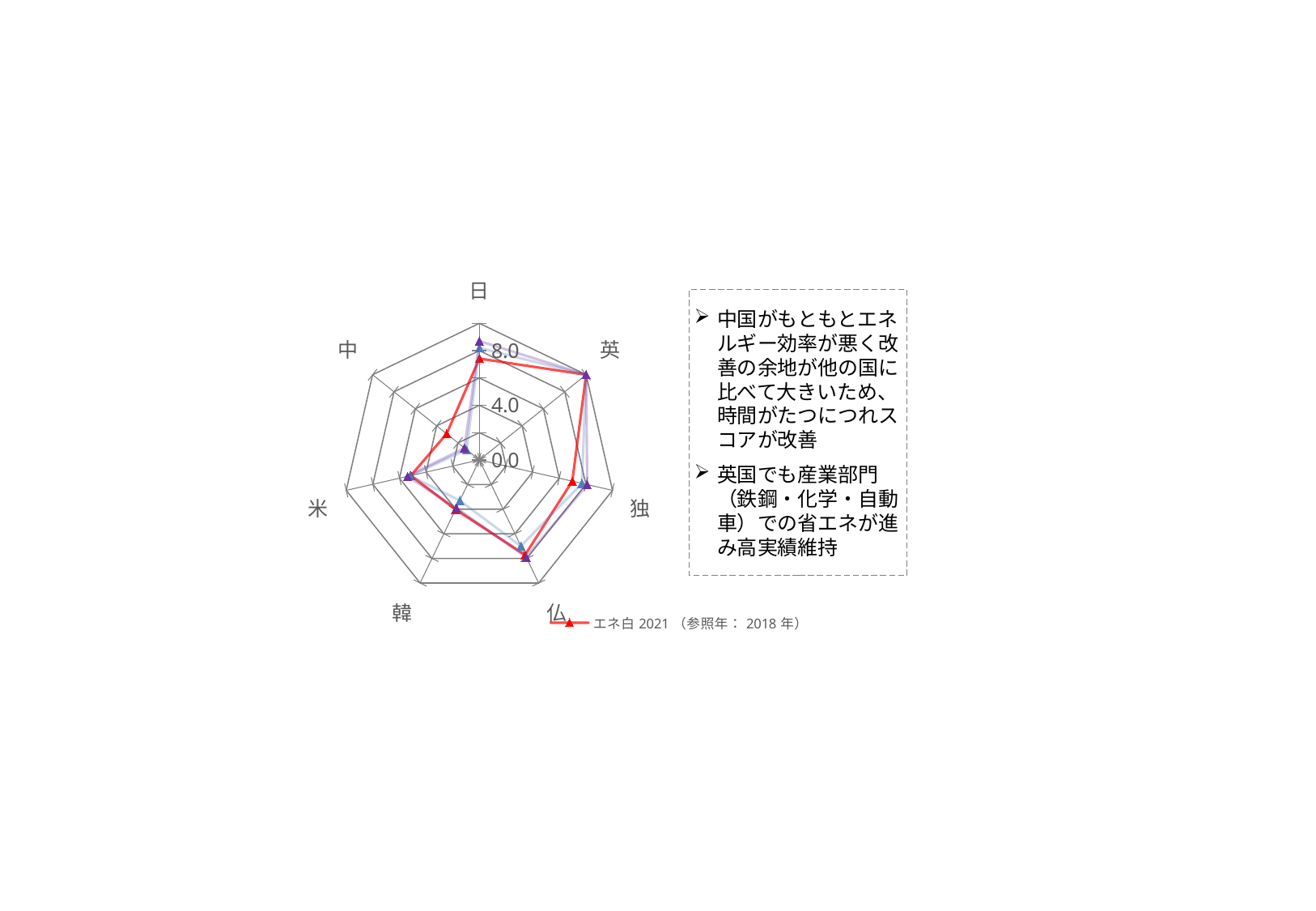
For the エネ白 2021 series, which is larger, the value for 日 or the value for 韓? 日 Is the エネ白 2021 value for 米 greater or less than 8.0? less For the エネ白 2021 series, which is larger, the value for 英 or the value for 中? 英 Is the エネ白 2021 value for 韓 greater or less than 8.0? less What kind of chart is shown on the slide? radar chart Is the エネ白 2021 value for 英 greater or less than 8.0? greater Which country has the lowest value for the エネ白 2021 series? 中 How many countries (categories) are plotted on the radar chart? 7 What is the reference year shown in the legend entry for エネ白 2021? 2018年 Which country has the highest value for the エネ白 2021 series? 英